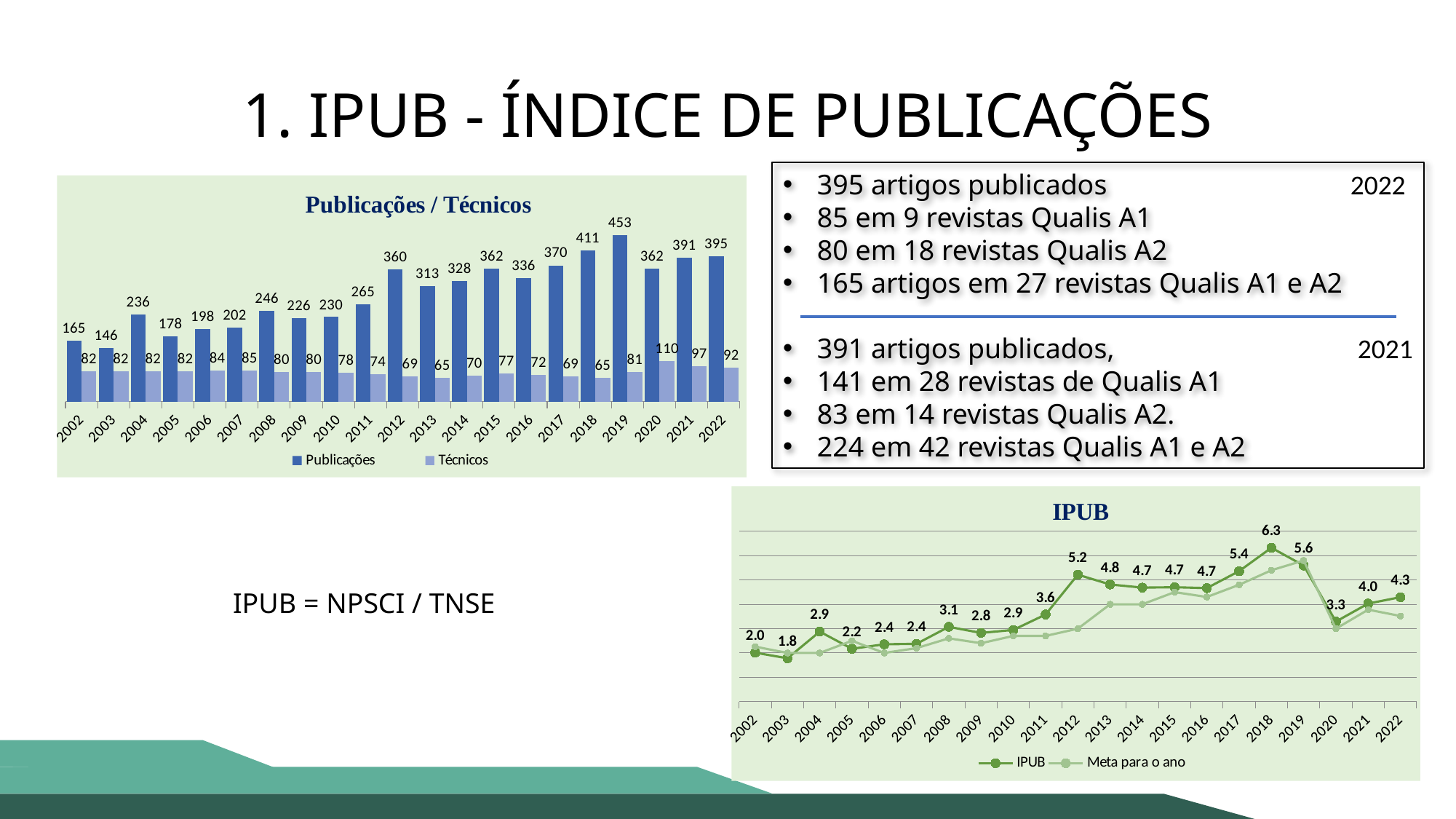
In the 'IPUB' chart, is the IPUB value for 2012 larger than the value for 2020? Yes In the 'Publicações / Técnicos' chart, which year has the highest Publicações value? 2019 In the 'Publicações / Técnicos' chart, what is the value of Técnicos for 2020? 110 In the 'Publicações / Técnicos' chart, what is the difference between Publicações in 2022 and 2021? 4 What kind of chart is the 'Publicações / Técnicos' chart? Bar chart In the 'IPUB' chart, how many years are shown on the x axis? 21 In the 'IPUB' chart, which year has the lowest IPUB value? 2003 In the 'IPUB' chart, what are the two series listed in the legend? IPUB and Meta para o ano In the 'Publicações / Técnicos' chart, how many series does the legend list? 2 In the 'Publicações / Técnicos' chart, which year has the lowest Publicações value? 2003 In the 'Publicações / Técnicos' chart, what is the value of Publicações for 2019? 453 In the 'IPUB' chart, what is the IPUB value for 2018? 6.3